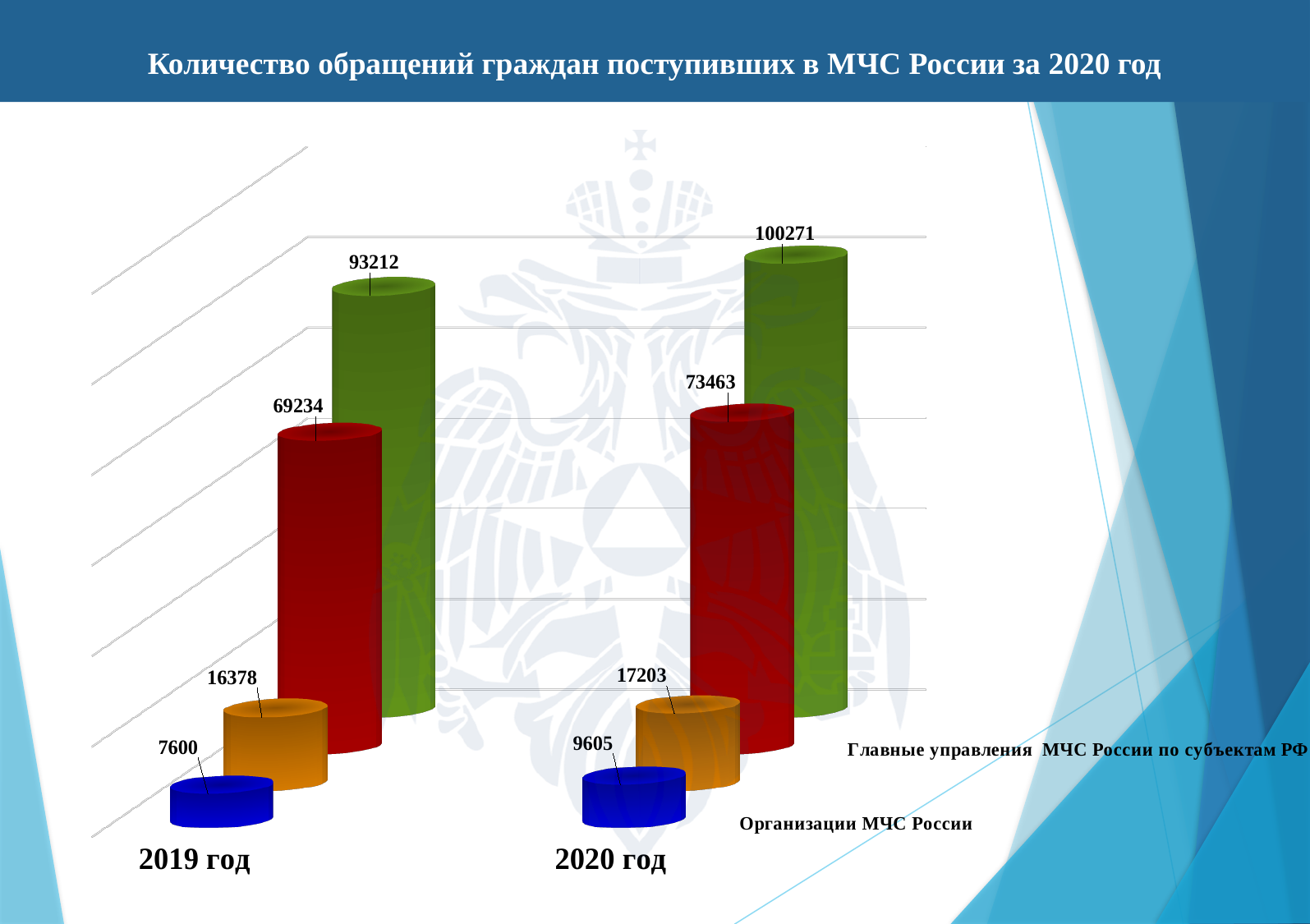
What is the lowest value shown on the chart? 7600 What is the highest value shown on the chart? 100271 What is the value of the green bar for 2020 год? 100271 What is the value of the orange bar for 2019 год? 16378 Which year has the larger orange bar value, 2019 год or 2020 год? 2020 год What is the value of the blue bar for 2020 год? 9605 What kind of chart is shown on the slide? Bar chart What is the difference between the red bar values for 2020 год and 2019 год? 4229 By how much did the green bar's value increase from 2019 год to 2020 год? 7059 What is the value of the red bar for 2019 год? 69234 How many year categories are shown on the x axis? 2 What is the value of the green bar for 2019 год? 93212